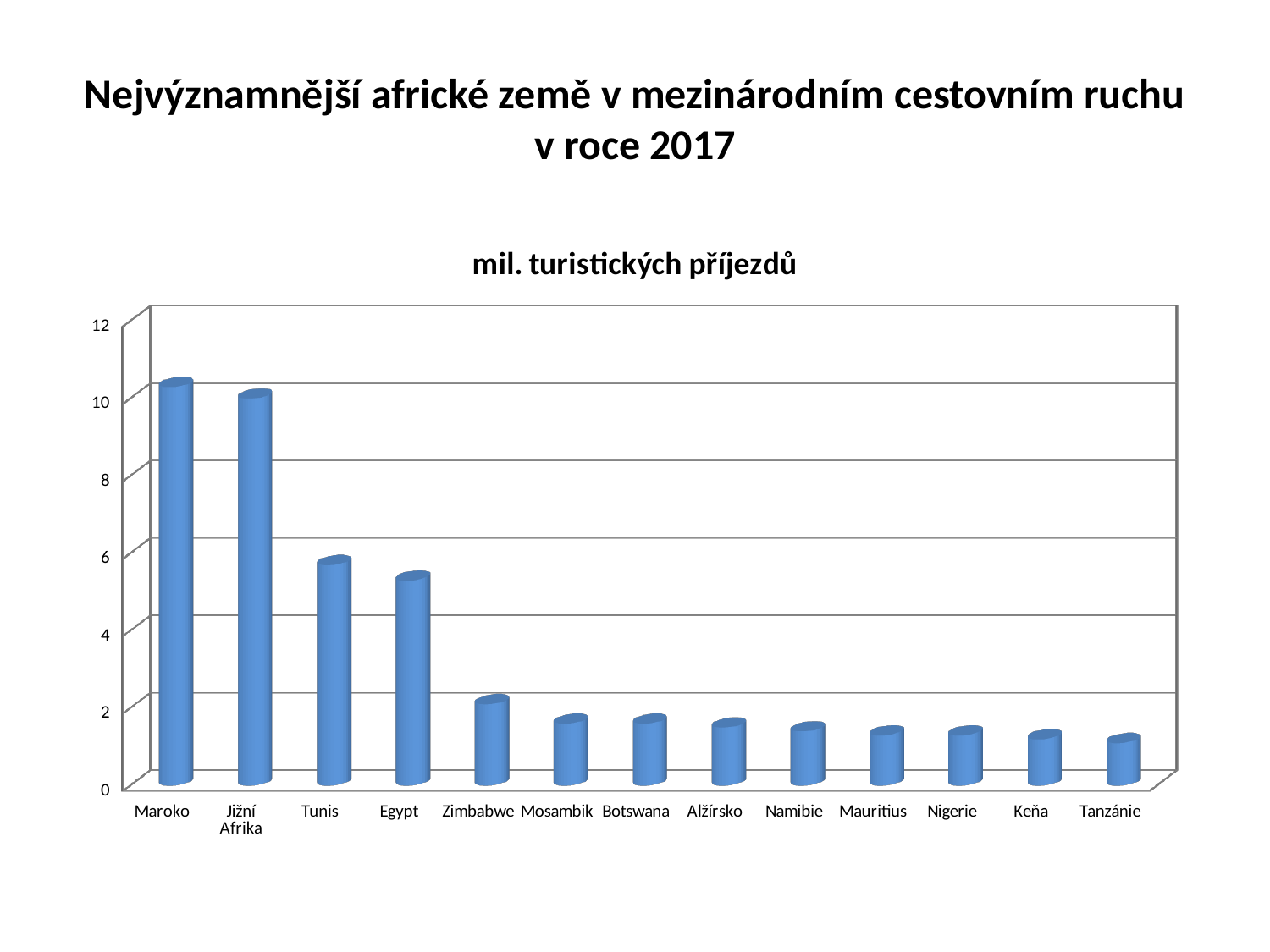
Is the value for Jižní Afrika greater or less than 8? greater Is the value for Mosambik greater or less than 2? less What kind of chart is shown on the slide? bar chart Is the value for Maroko greater or less than 8? greater Which country has the highest value in the chart? Maroko How many countries are shown on the x axis of the chart? 13 Do the values rise or fall from left to right along the x axis? fall Which has the larger value, Tunis or Egypt? Tunis What is the title of the chart? mil. turistických příjezdů